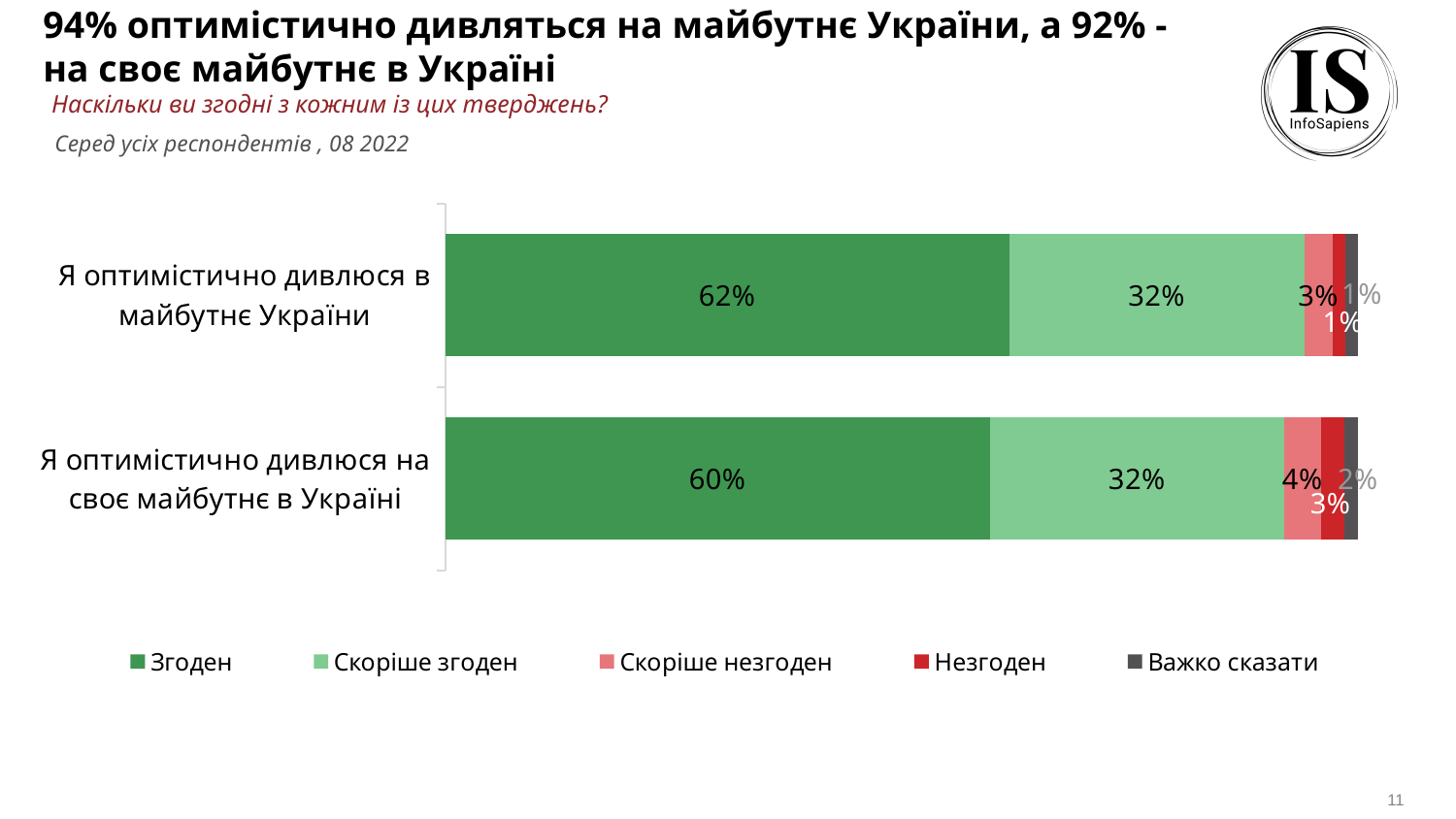
What type of chart is shown on the slide? Stacked bar chart Which legend entry is shown in dark green? Згоден What percentage of respondents answered "Згоден" to "Я оптимістично дивлюся в майбутнє України"? 62% What is the "Скоріше незгоден" value for "Я оптимістично дивлюся на своє майбутнє в Україні"? 4% What is the "Незгоден" value for "Я оптимістично дивлюся на своє майбутнє в Україні"? 3% What is the difference in percentage points between the "Згоден" values of the two statements? 2 percentage points What is the "Скоріше згоден" value for "Я оптимістично дивлюся в майбутнє України"? 32% What is the "Важко сказати" value for "Я оптимістично дивлюся в майбутнє України"? 1% Which statement has the higher "Згоден" share: "Я оптимістично дивлюся в майбутнє України" or "Я оптимістично дивлюся на своє майбутнє в Україні"? Я оптимістично дивлюся в майбутнє України How many statements (categories) are shown in the chart? 2 How many answer options does the legend list? 5 What percentage of respondents answered "Згоден" to "Я оптимістично дивлюся на своє майбутнє в Україні"? 60%